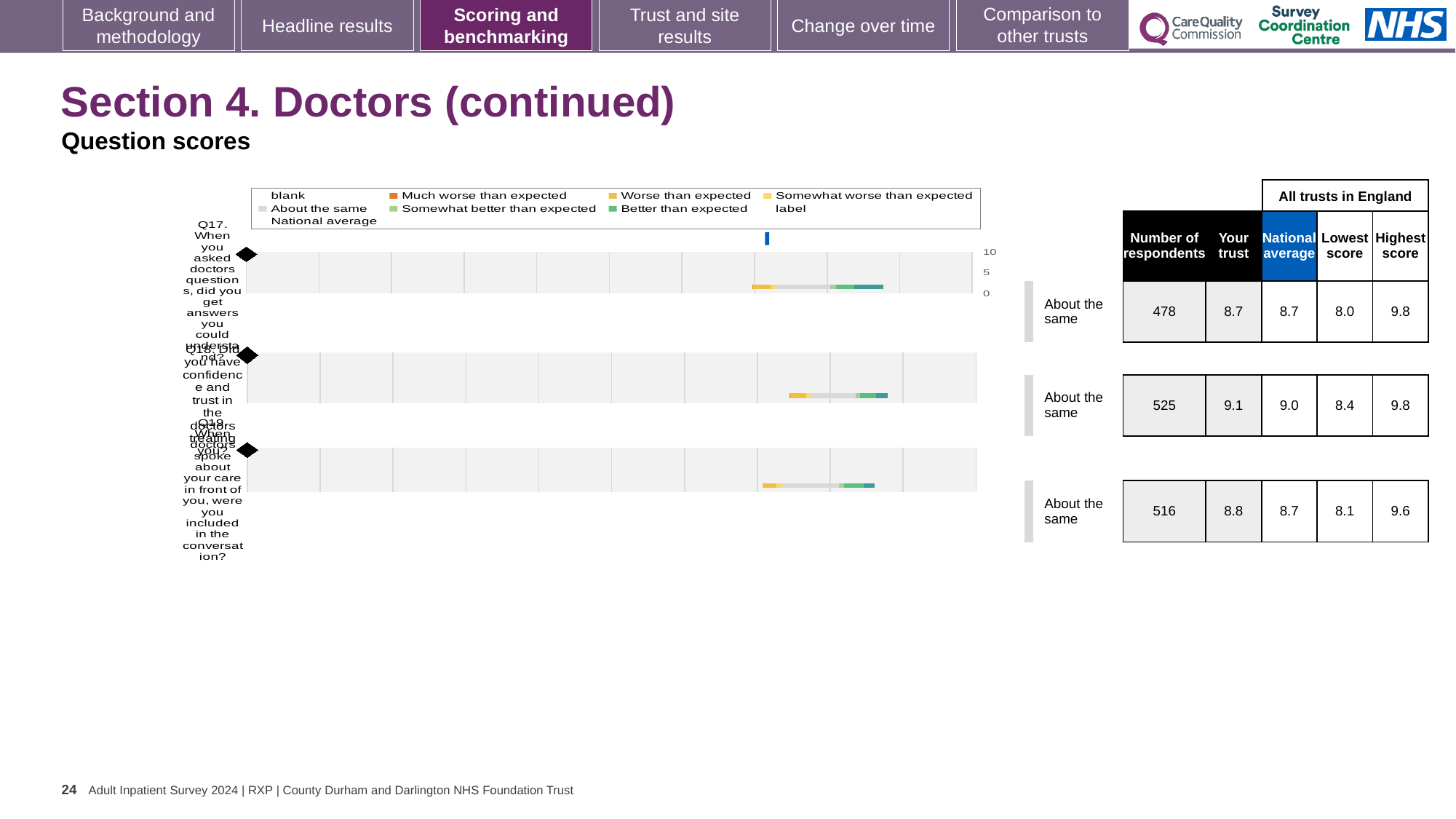
What is the difference between the 'Your trust' score and the national average for Q18? 0.1 What is the national average score for Q19 (When doctors spoke about your care in front of you, were you included in the conversation?)? 8.7 Which question has the highest 'Your trust' score? Q18 What is the highest score among all trusts in England for Q19? 9.6 What kind of chart is used to show the question scores on this slide? bar chart What is the 'Your trust' score for Q17 (When you asked doctors questions, did you get answers you could understand?)? 8.7 How many entries does the chart legend list? 9 What benchmark category is shown next to each of the three questions? About the same Is the 'Your trust' score for Q17 greater or less than 5 on the chart axis? greater What is the number of respondents for Q18 (Did you have confidence and trust in the doctors treating you?)? 525 How many questions (categories) are plotted in the chart? 3 Which has the larger 'Your trust' score, Q18 or Q19? Q18